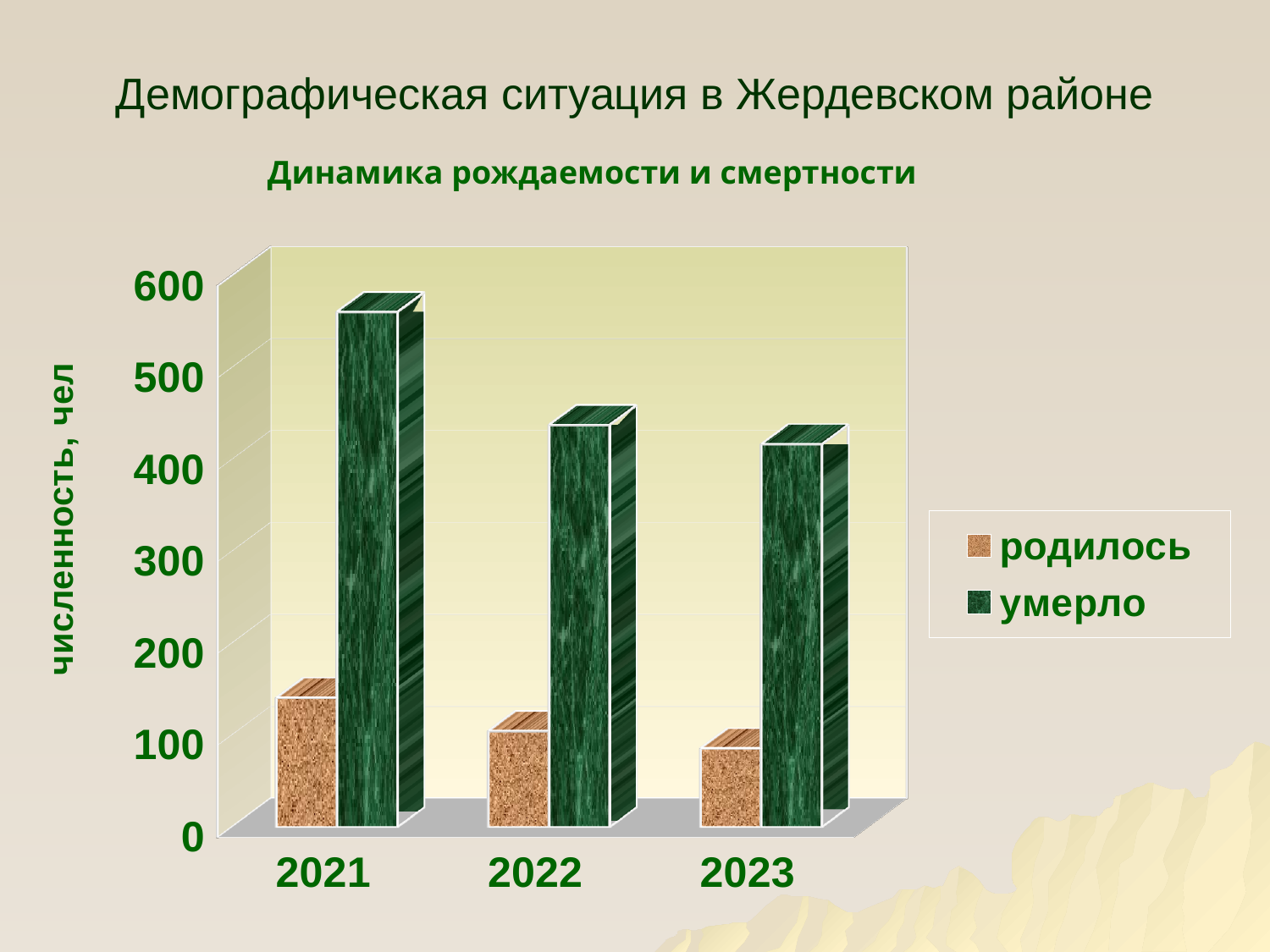
What is the title of the chart? Динамика рождаемости и смертности Do the values for умерло rise or fall from 2021 to 2023? fall Is the value for умерло in 2022 greater or less than 500? less Is the value for умерло in 2021 greater or less than 500? greater Which is larger in 2021, родилось or умерло? умерло In which year is the value for родилось lowest? 2023 Is the value for родилось in 2021 greater or less than 100? greater How many years are shown on the x axis? 3 In which year is the value for родилось highest? 2021 How many series does the legend list? 2 In which year is the value for умерло highest? 2021 What kind of chart is shown on the slide? bar chart